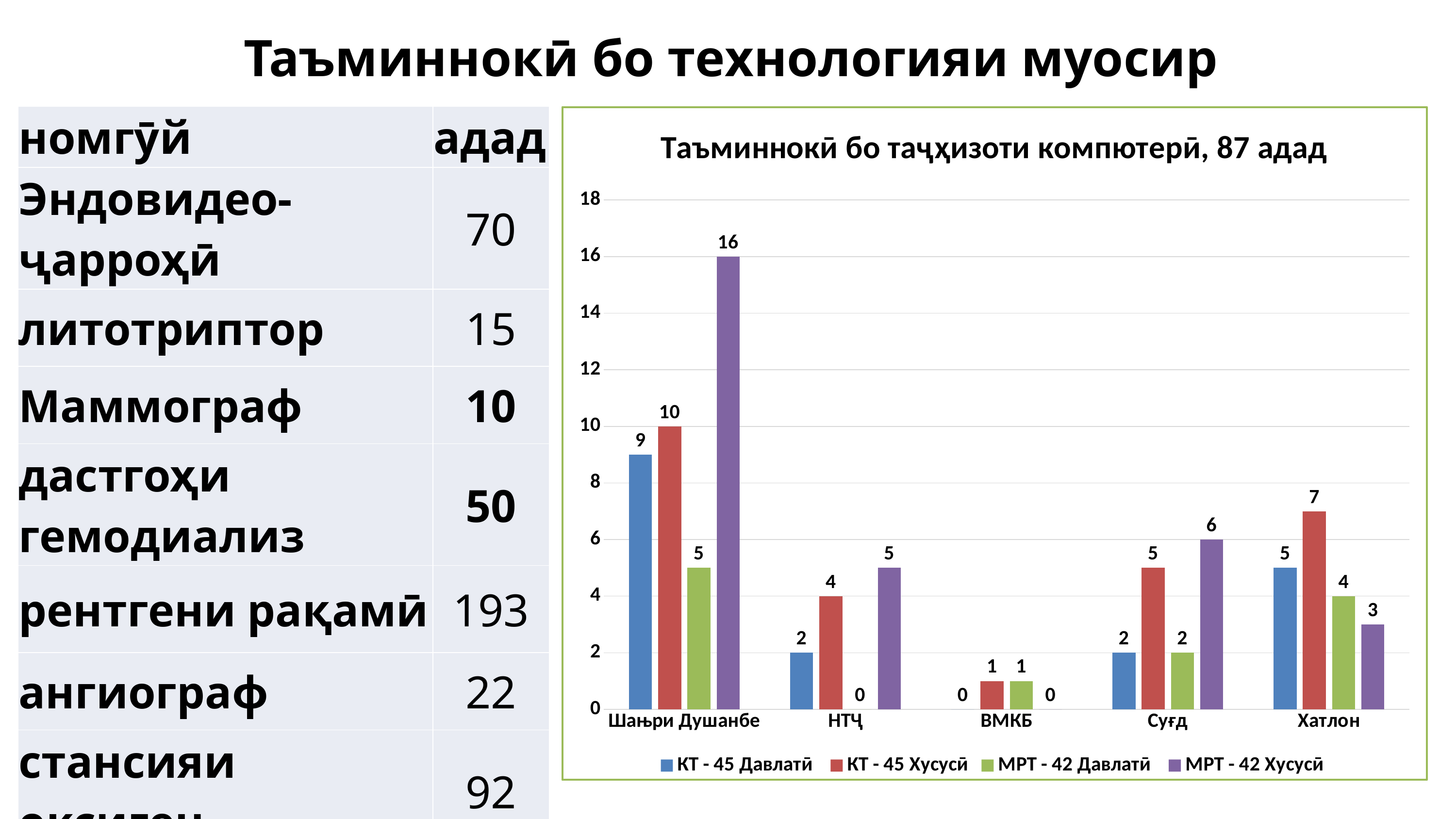
What is the title of the chart? Таъминнокӣ бо таҷҳизоти компютерӣ, 87 адад How many categories are shown on the x axis? 5 Which is larger in Хатлон: КТ - 45 Давлатӣ or КТ - 45 Хусусӣ? КТ - 45 Хусусӣ What is the value for КТ - 45 Давлатӣ in НТҶ? 2 What is the value for МРТ - 42 Хусусӣ in Хатлон? 3 Which category has the highest value for МРТ - 42 Хусусӣ? Шаҳри Душанбе Which category has the lowest value for КТ - 45 Хусусӣ? ВМКБ How many series does the legend list? 4 What is the total of the four series values for Суғд? 15 What is the difference between the МРТ - 42 Хусусӣ value in Шаҳри Душанбе and in Суғд? 10 What kind of chart is shown? bar chart What is the value for КТ - 45 Хусусӣ in Шаҳри Душанбе? 10